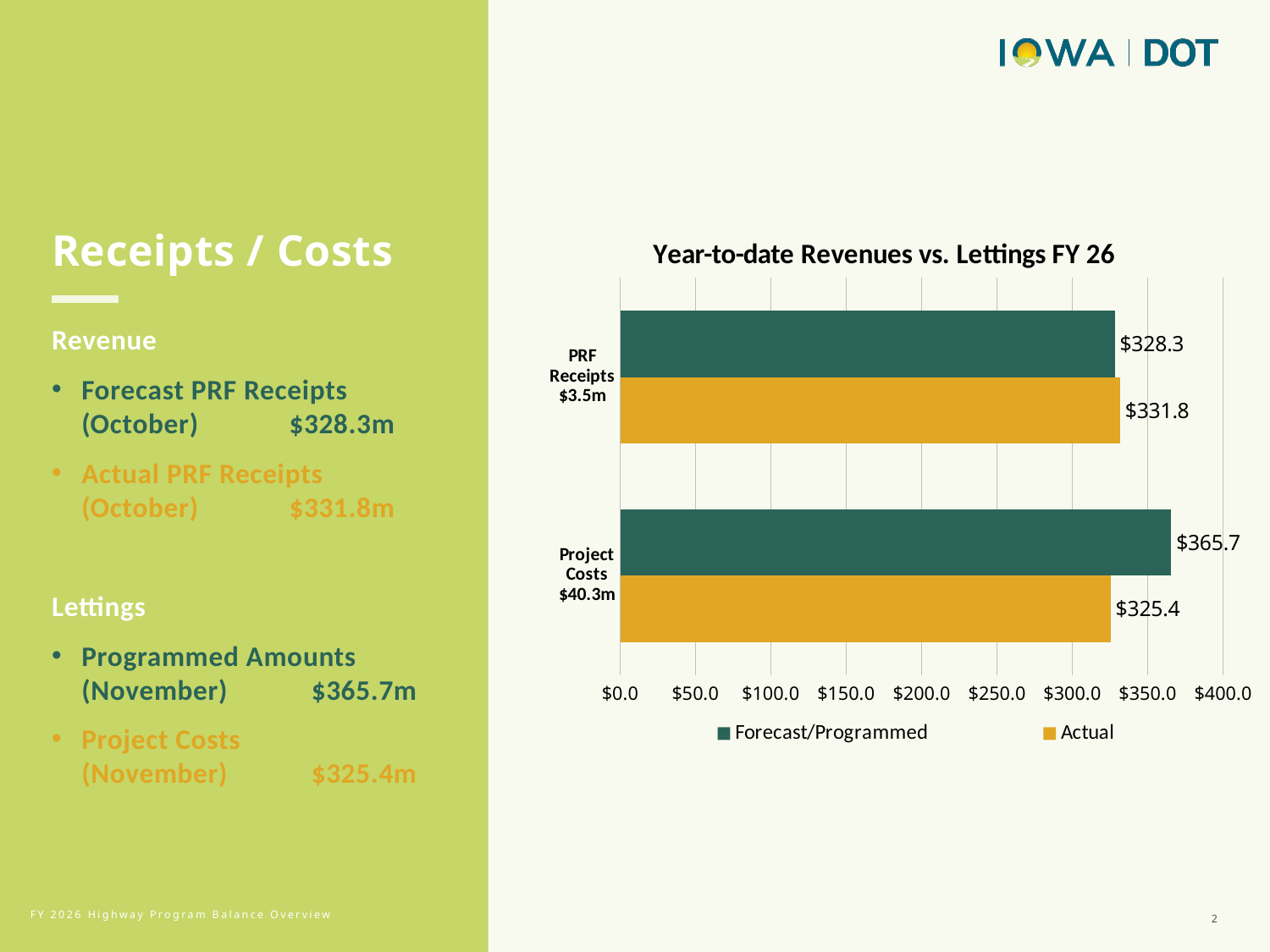
What is the Forecast/Programmed value for Project Costs? $365.7 What is the Actual value for PRF Receipts? $331.8 What is the Forecast/Programmed value for PRF Receipts? $328.3 What is the title of the chart? Year-to-date Revenues vs. Lettings FY 26 What type of chart is shown on the slide? Bar chart Which bar has the highest value on the chart? Project Costs, Forecast/Programmed ($365.7) What is the difference between the Forecast/Programmed and Actual values for Project Costs? $40.3 How many categories are shown on the chart? 2 What is the Actual value for Project Costs? $325.4 Which series is shown in orange in the legend? Actual For PRF Receipts, which is larger: the Forecast/Programmed value or the Actual value? Actual How many series does the chart legend list? 2